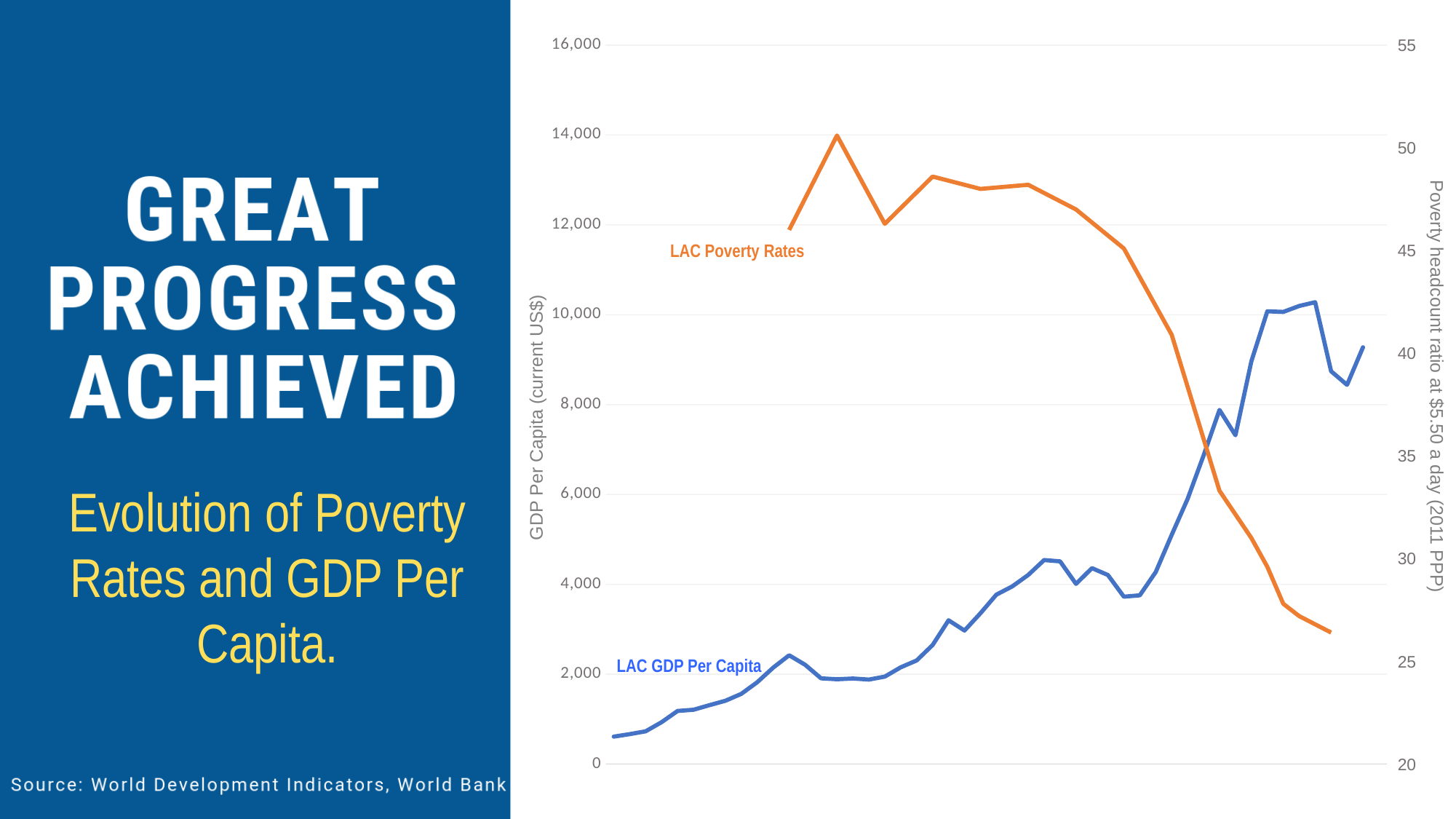
How many data series are plotted on the chart? 2 Is the last plotted value of LAC GDP Per Capita greater or less than 8,000? greater Does the LAC Poverty Rates line rise or fall overall from left to right? Fall What colour is the LAC Poverty Rates line? Orange Does the LAC GDP Per Capita line rise or fall overall from left to right? Rise Is the highest value of the LAC Poverty Rates line greater or less than 45? greater What is the title of the left vertical axis? GDP Per Capita (current US$) Is the first plotted value of LAC GDP Per Capita greater or less than 2,000? less What kind of chart is shown on the slide? Line chart